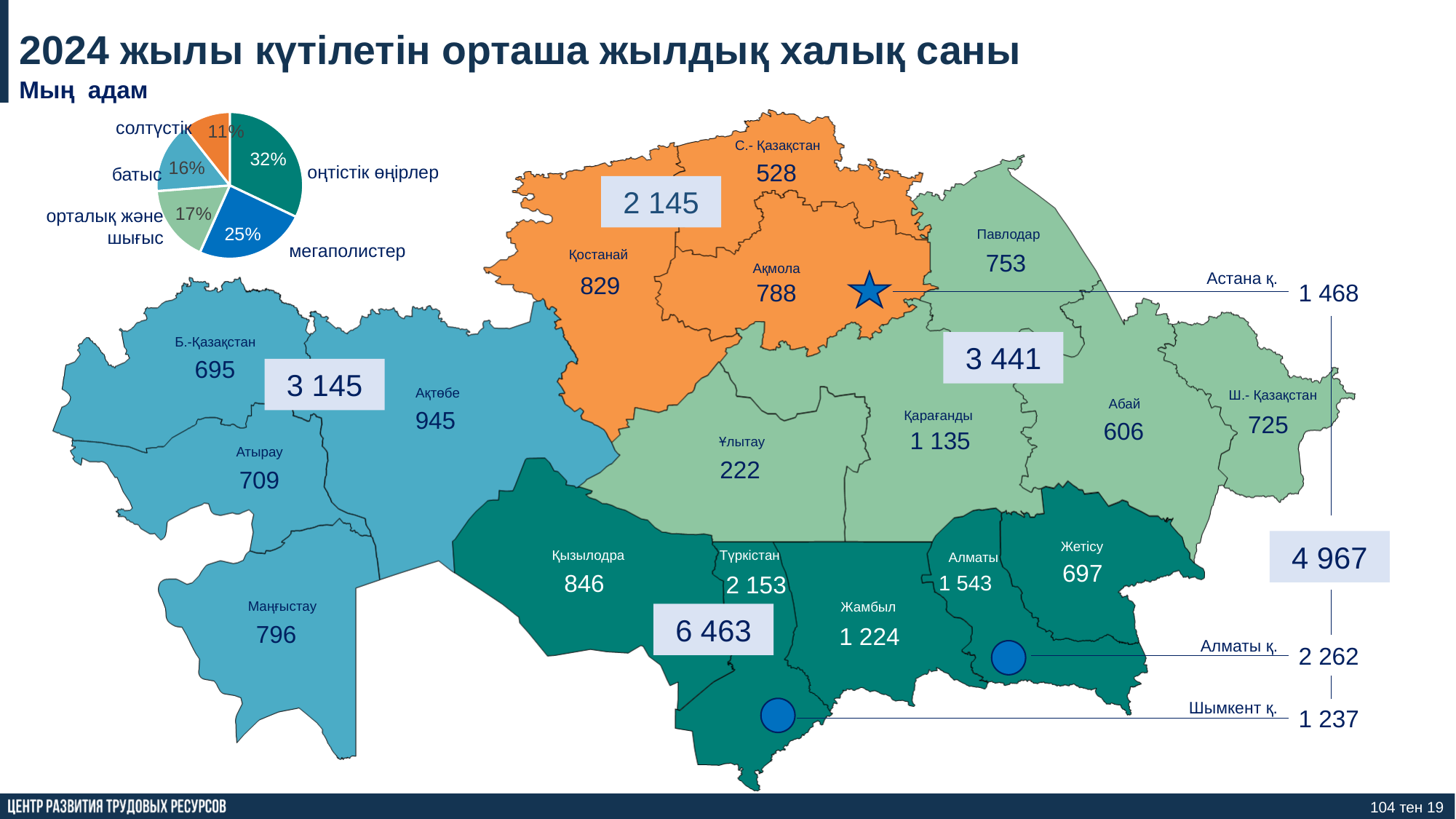
How many slices does the pie chart have? 5 In the pie chart, what share is shown for мегаполистер? 25% In the pie chart, what share is shown for оңтістік өңірлер? 32% In the pie chart, which slice is the smallest? солтүстік On the map, what value is shown for Астана қ.? 1 468 In the pie chart, which slice is the largest? оңтістік өңірлер In the pie chart, what share is shown for орталық және шығыс? 17% In the pie chart, what is the difference in percentage points between оңтістік өңірлер and мегаполистер? 7 In the pie chart, what share is shown for солтүстік? 11% In the pie chart, what share is shown for батыс? 16% In the pie chart, which is larger: батыс or орталық және шығыс? орталық және шығыс What kind of chart is shown in the top-left corner of the slide? pie chart